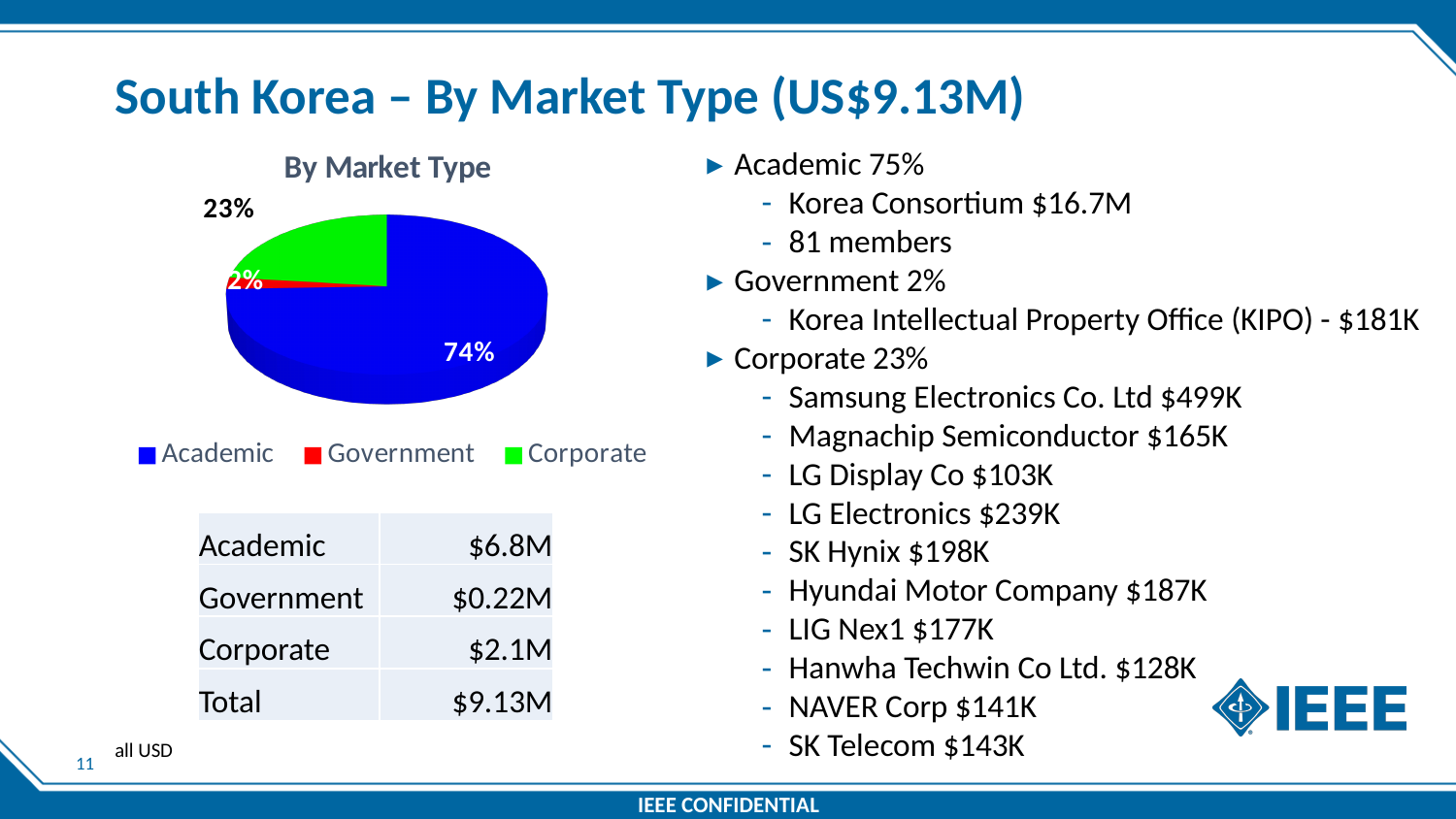
What share of the pie does Academic hold in the By Market Type chart? 74% In the By Market Type chart, which slice is larger, Corporate or Government? Corporate What is the title of the chart on the slide? By Market Type How many slices does the By Market Type pie chart have? 3 What colour represents Corporate in the By Market Type chart? Green What share of the pie does Corporate hold in the By Market Type chart? 23% How many entries does the legend of the By Market Type chart list? 3 What share of the pie does Government hold in the By Market Type chart? 2% Which category has the largest slice in the By Market Type chart? Academic In the By Market Type chart, how many percentage points larger is the Academic slice than the Corporate slice? 51 Which category has the smallest slice in the By Market Type chart? Government What kind of chart is shown on the slide? Pie chart